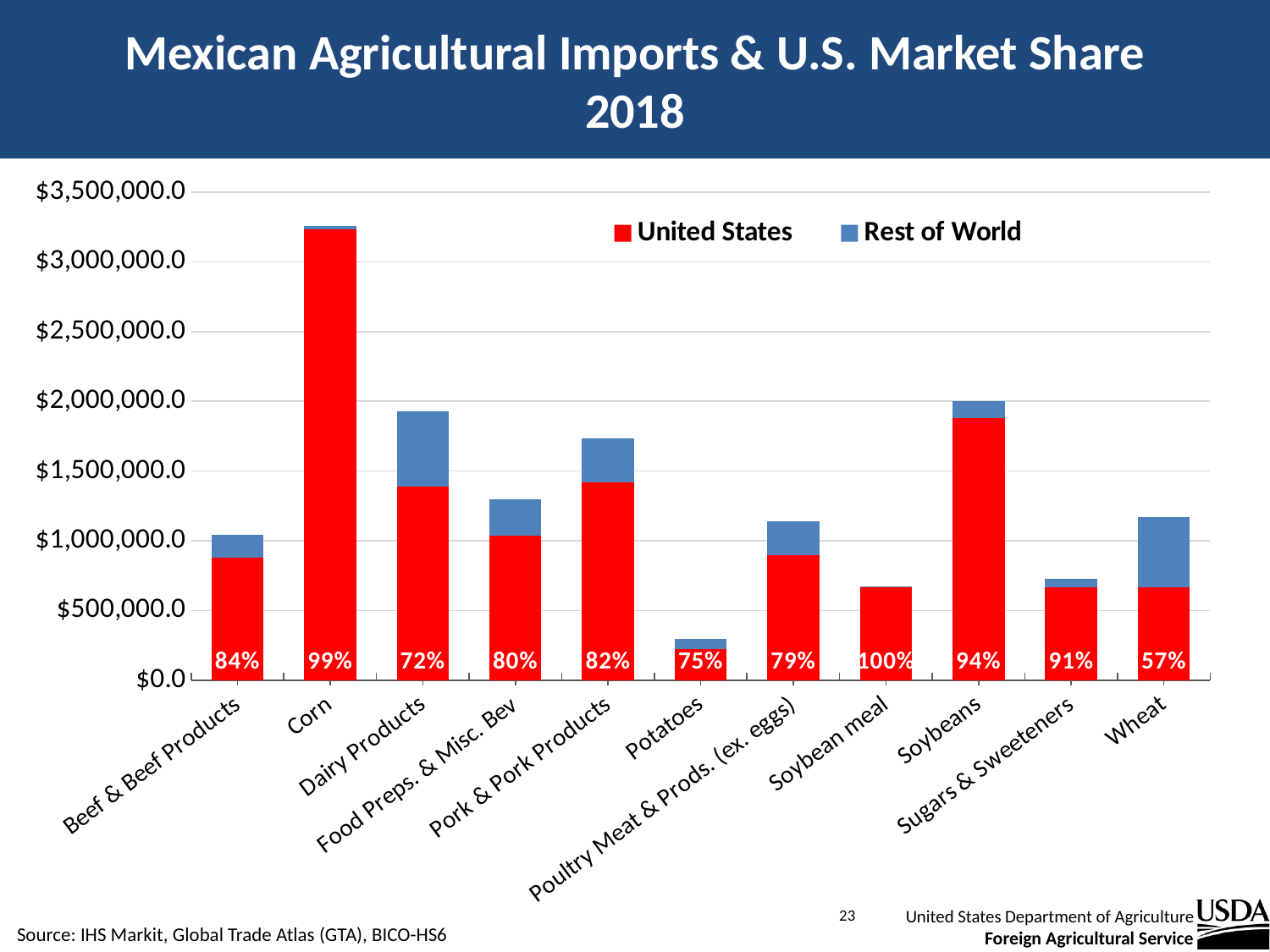
Is the total bar for Potatoes greater or less than $500,000.0? less Which category has the lowest U.S. market share percentage label? Wheat What U.S. market share percentage is shown for Wheat? 57% Which category has the highest U.S. market share percentage label? Soybean meal How many series does the legend list? 2 What U.S. market share percentage is shown for Dairy Products? 72% Which category has the tallest total bar? Corn How many product categories are shown on the x axis? 11 What U.S. market share percentage is shown for Corn? 99% What is the difference in percentage points between the U.S. market share for Soybeans and for Dairy Products? 22 percentage points Is the total bar for Corn greater or less than $3,000,000.0? greater Which has a higher U.S. market share percentage, Beef & Beef Products or Pork & Pork Products? Beef & Beef Products